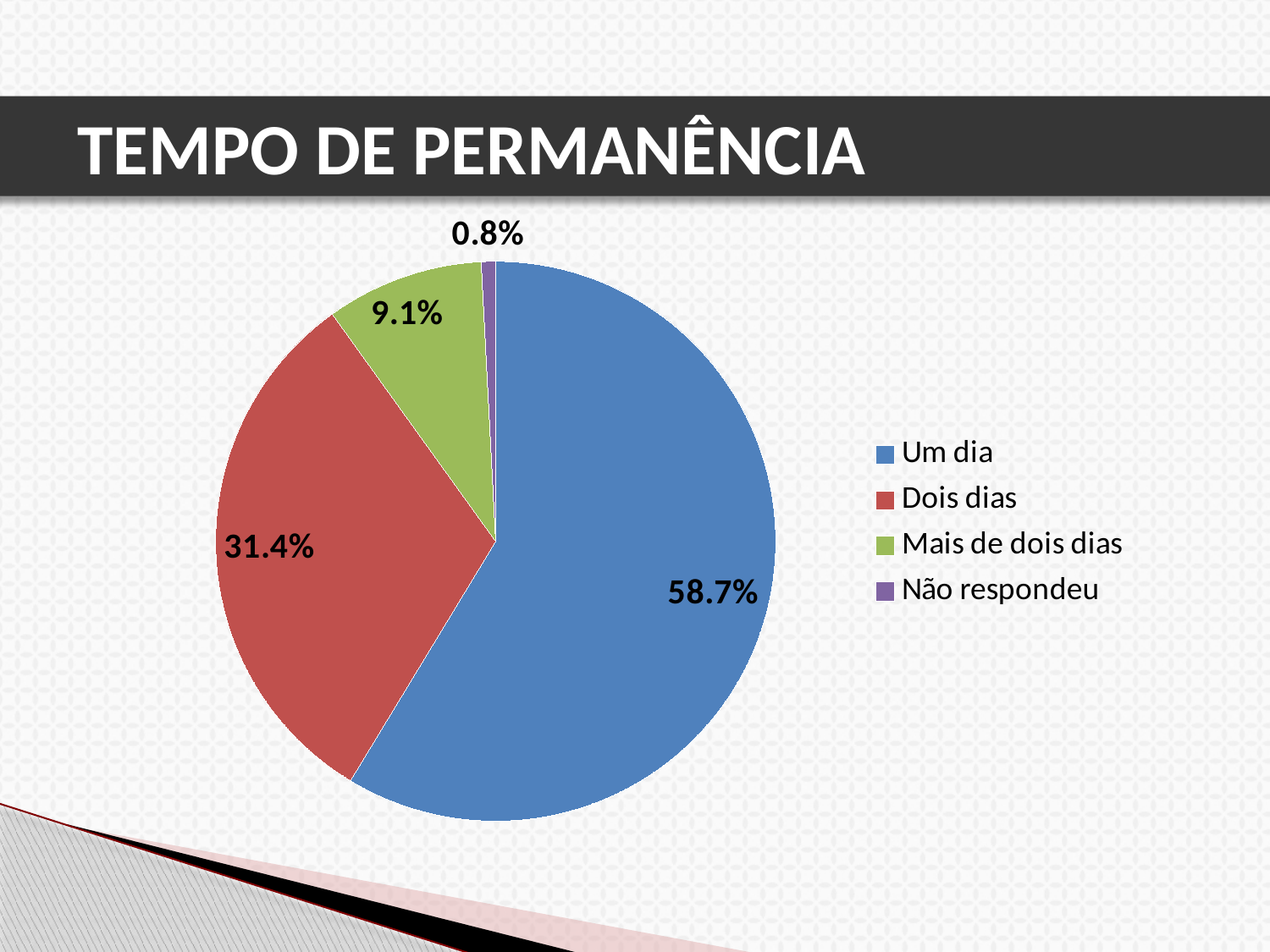
What colour is the slice for "Mais de dois dias"? green What percentage of the pie corresponds to "Não respondeu"? 0.8% What is the title of the slide containing the chart? TEMPO DE PERMANÊNCIA What percentage of the pie corresponds to "Mais de dois dias"? 9.1% Which category has the largest slice of the pie? Um dia How many categories does the legend list? 4 Which category has the smallest slice of the pie? Não respondeu What is the difference in percentage points between "Um dia" and "Dois dias"? 27.3 Which is larger, the slice for "Dois dias" or the slice for "Mais de dois dias"? Dois dias What percentage of the pie corresponds to "Dois dias"? 31.4% What type of chart is shown on the slide? pie chart What percentage of the pie corresponds to "Um dia"? 58.7%